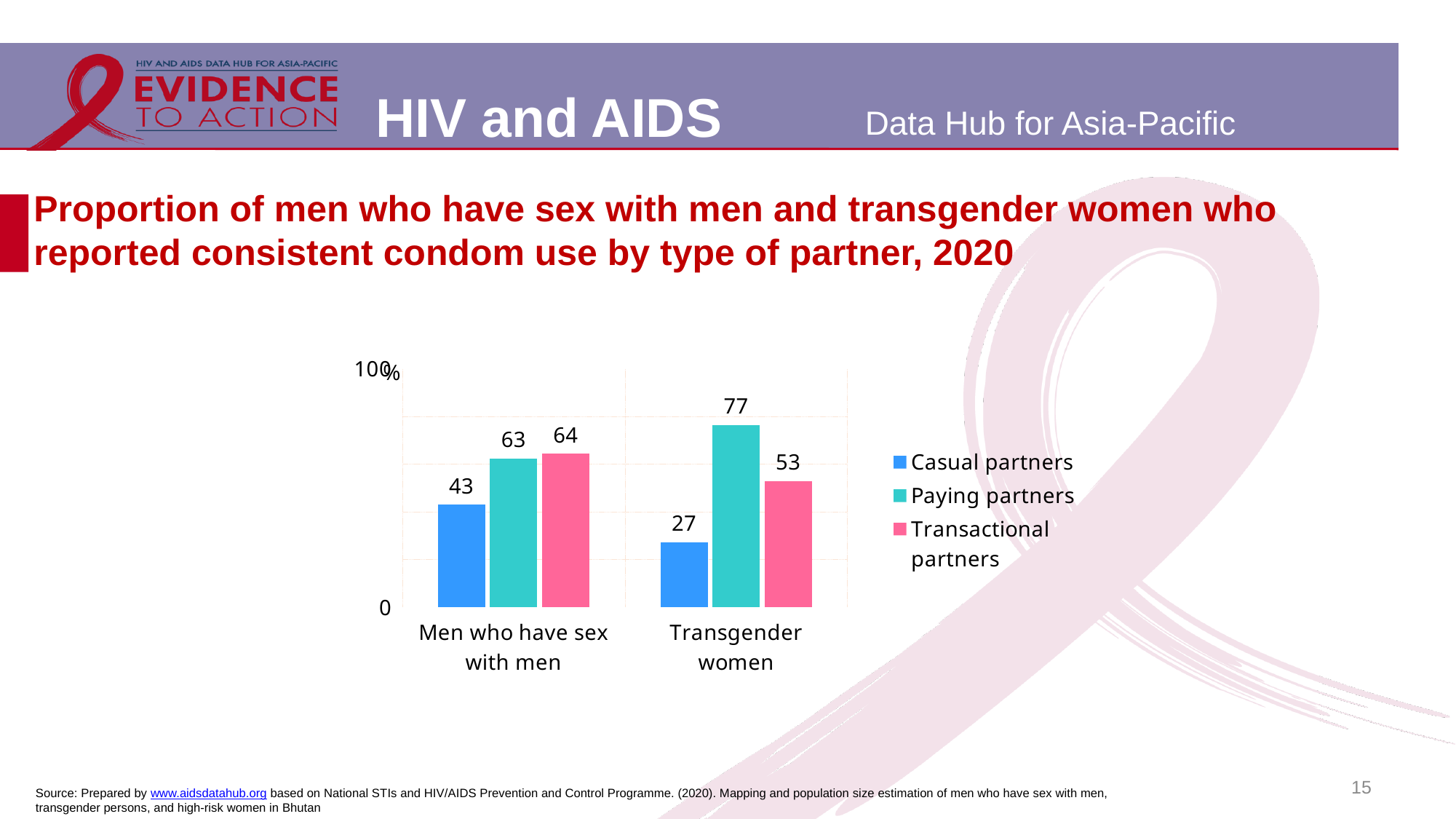
What is the value for Transactional partners among men who have sex with men? 64 What is the value for Paying partners among transgender women? 77 What kind of chart is shown on the slide? Bar chart Which partner type has the lowest value among men who have sex with men? Casual partners What is the value for Casual partners among men who have sex with men? 43 How many population groups are shown on the x axis? 2 What colour represents Paying partners in the chart? Teal What is the value for Casual partners among transgender women? 27 What is the difference between the Paying partners values for transgender women and men who have sex with men? 14 Which partner type has the highest value among transgender women? Paying partners Which is larger: the Transactional partners value for men who have sex with men or for transgender women? Men who have sex with men How many series does the legend list? 3